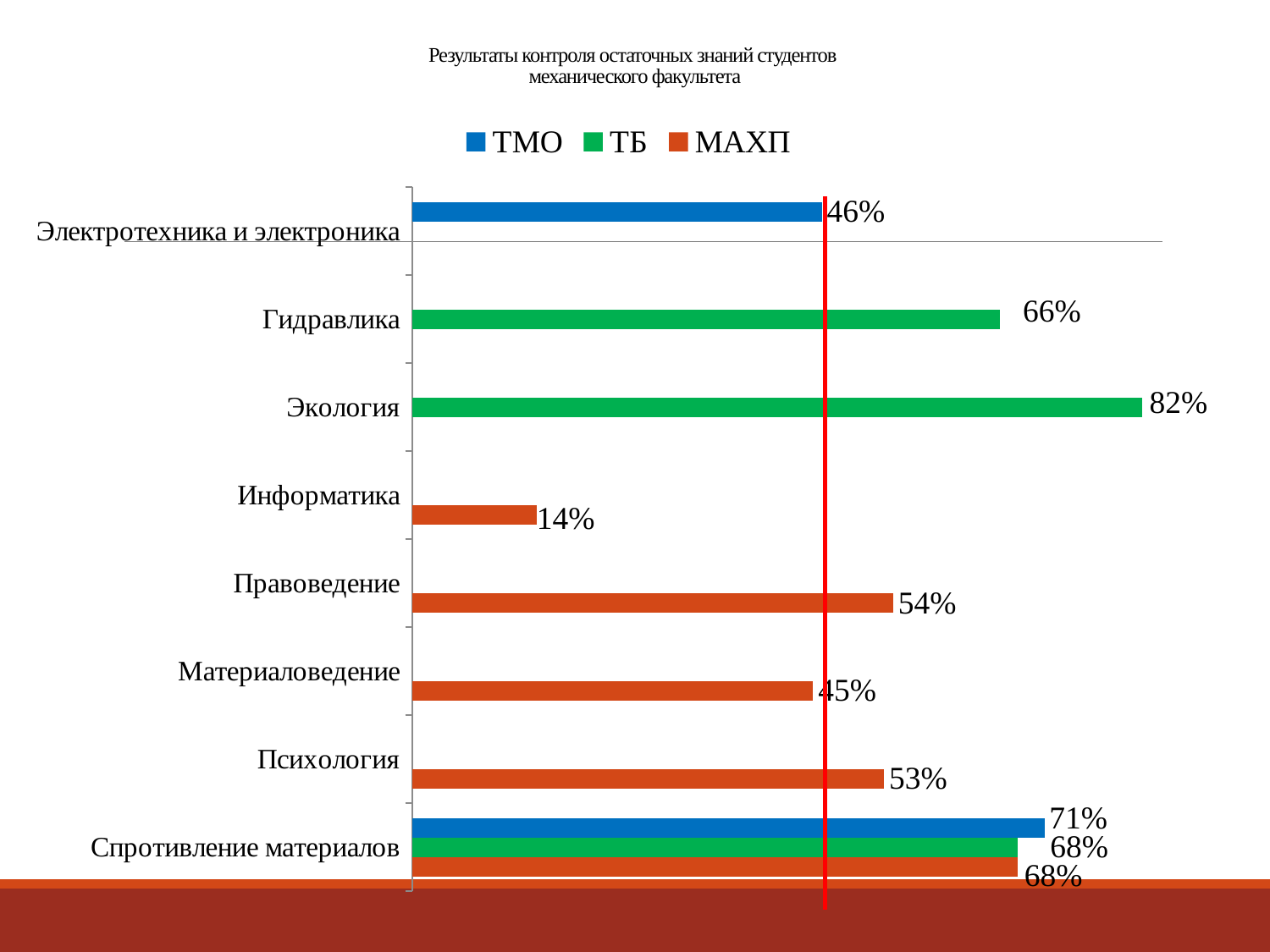
What is the value for ТМО in Электротехника и электроника? 46% Which category has the lowest value on the chart? Информатика What is the value for ТБ in Экология? 82% How many series does the legend list? 3 What is the value for МАХП in Информатика? 14% How many categories are shown on the vertical axis of the chart? 8 What is the value for ТМО in Спротивление материалов? 71% Which series is shown in green in the legend? ТБ What is the difference between the ТБ value for Экология and the ТБ value for Гидравлика? 16% What type of chart is shown on the slide? bar chart Which category has the highest value on the chart? Экология Which is larger: the МАХП value for Правоведение or the МАХП value for Материаловедение? Правоведение